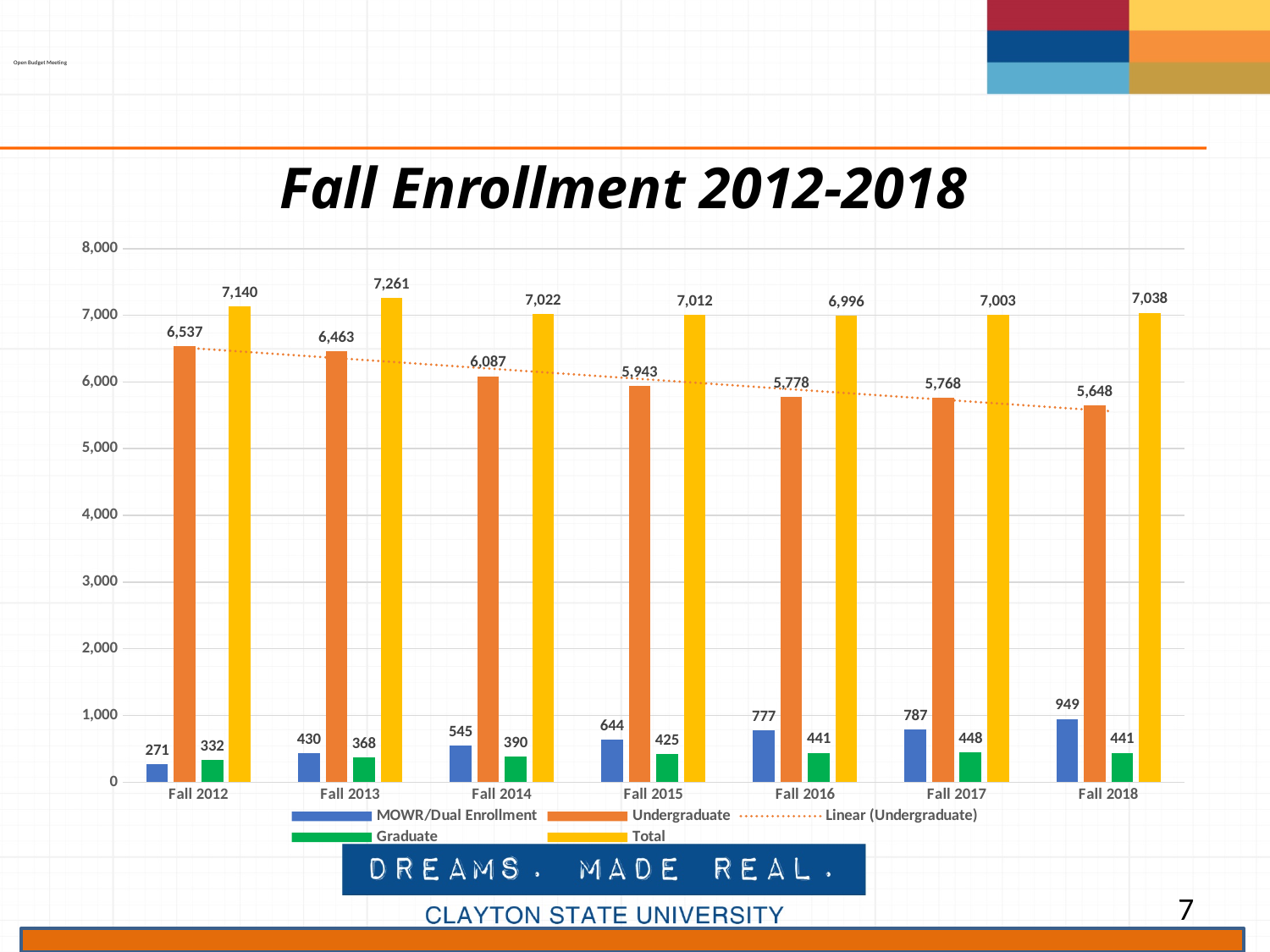
How many entries does the legend list? 5 Which fall term has the lowest Undergraduate enrollment? Fall 2018 What is the Undergraduate enrollment for Fall 2012? 6,537 How many fall terms are shown on the x axis? 7 What is the MOWR/Dual Enrollment value for Fall 2016? 777 Which is larger, the MOWR/Dual Enrollment value for Fall 2015 or the Graduate value for Fall 2015? MOWR/Dual Enrollment (644) Does the Undergraduate enrollment rise or fall from Fall 2012 to Fall 2018? fall Which fall term has the highest Total enrollment? Fall 2013 What is the Total enrollment for Fall 2018? 7,038 Is the Undergraduate enrollment for Fall 2016 greater or less than 6,000? less What is the Graduate enrollment for Fall 2014? 390 What is the difference between the Undergraduate enrollment in Fall 2012 and Fall 2018? 889